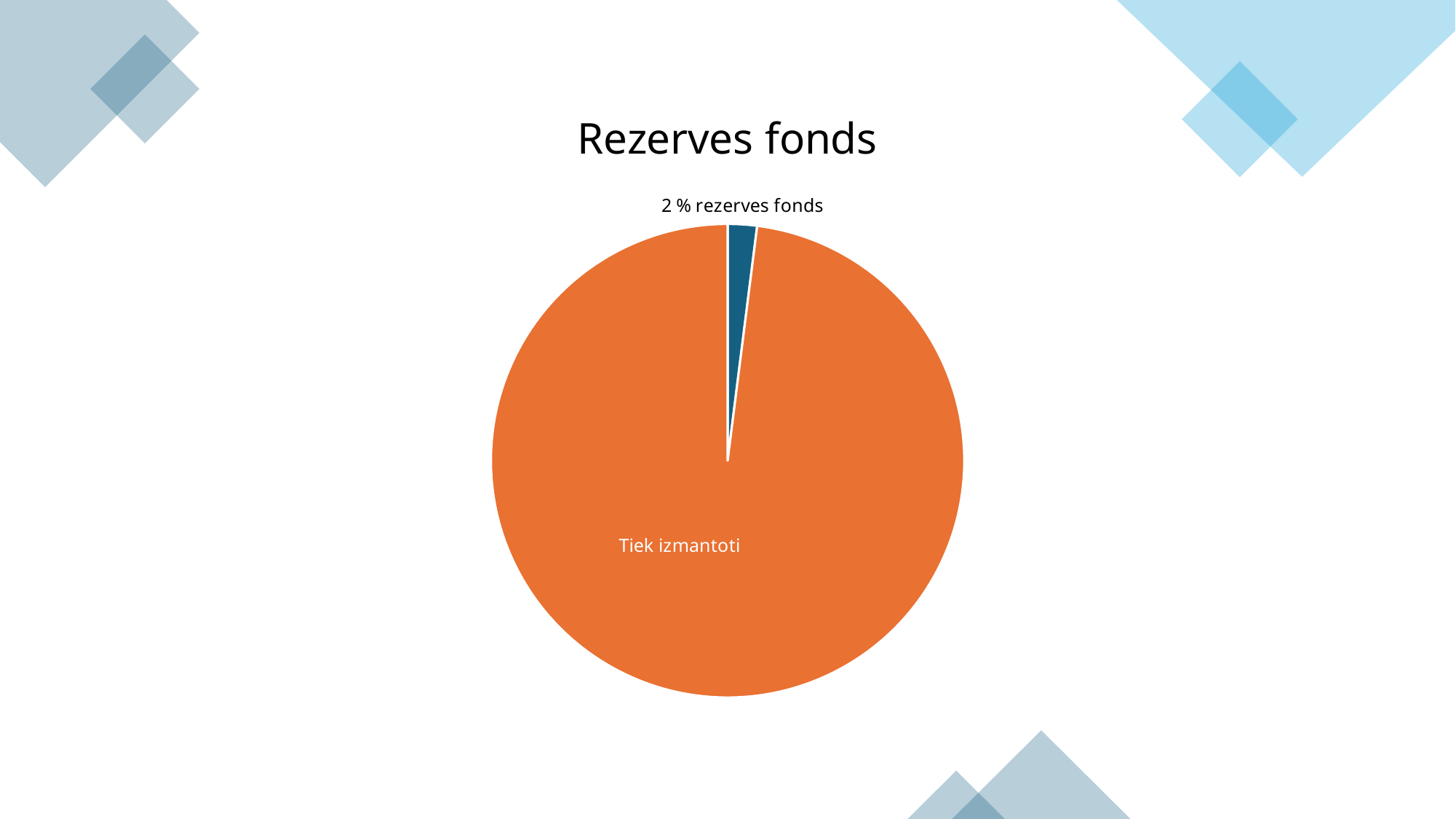
Which slice of the pie chart is the smallest? 2 % rezerves fonds What kind of chart is shown on the slide? pie chart What colour is the "Tiek izmantoti" slice? orange What is the label of the small dark blue slice? 2 % rezerves fonds Which slice of the pie chart is the largest? Tiek izmantoti How many slices does the pie chart have? 2 What is the title of the chart? Rezerves fonds What percentage is printed in the label of the smaller slice? 2 % Which slice is larger, "Tiek izmantoti" or "2 % rezerves fonds"? Tiek izmantoti